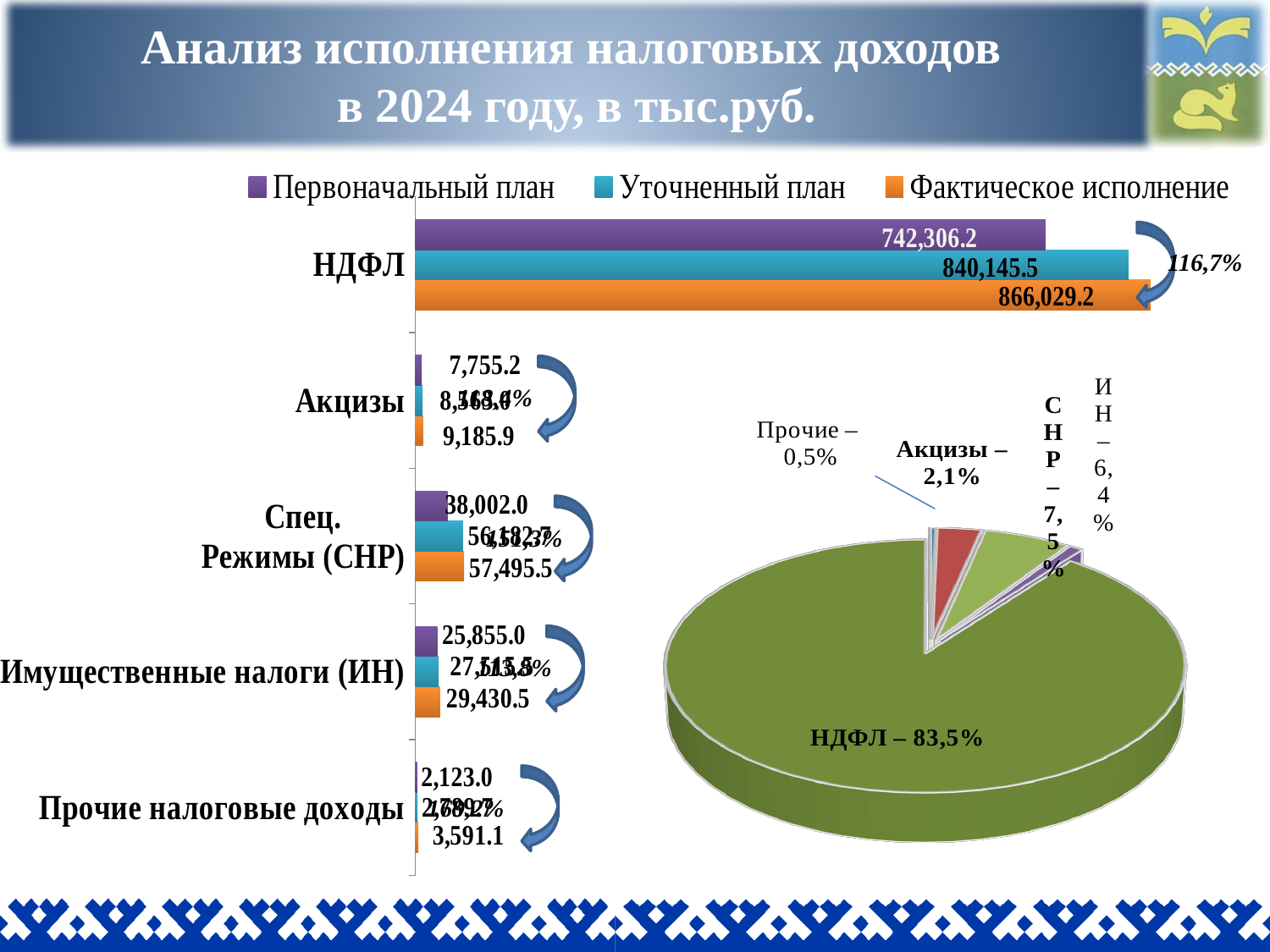
In the bar chart, what is the difference between the Фактическое исполнение and Первоначальный план values for НДФЛ? 123,723.0 In the bar chart, what is the Фактическое исполнение value for НДФЛ? 866,029.2 In the bar chart, what is the Фактическое исполнение value for Прочие налоговые доходы? 3,591.1 In the pie chart, what share does НДФЛ have? 83,5% How many categories are shown in the bar chart? 5 In the bar chart, what is the Фактическое исполнение value for Спец. Режимы (СНР)? 57,495.5 In the bar chart, what is the Уточненный план value for НДФЛ? 840,145.5 How many series does the bar chart's legend list? 3 In the bar chart, what is the Первоначальный план value for Имущественные налоги (ИН)? 25,855.0 In the bar chart, what is the Первоначальный план value for НДФЛ? 742,306.2 In the bar chart, which category has the highest Фактическое исполнение value? НДФЛ In the pie chart, what share does Акцизы have? 2,1%